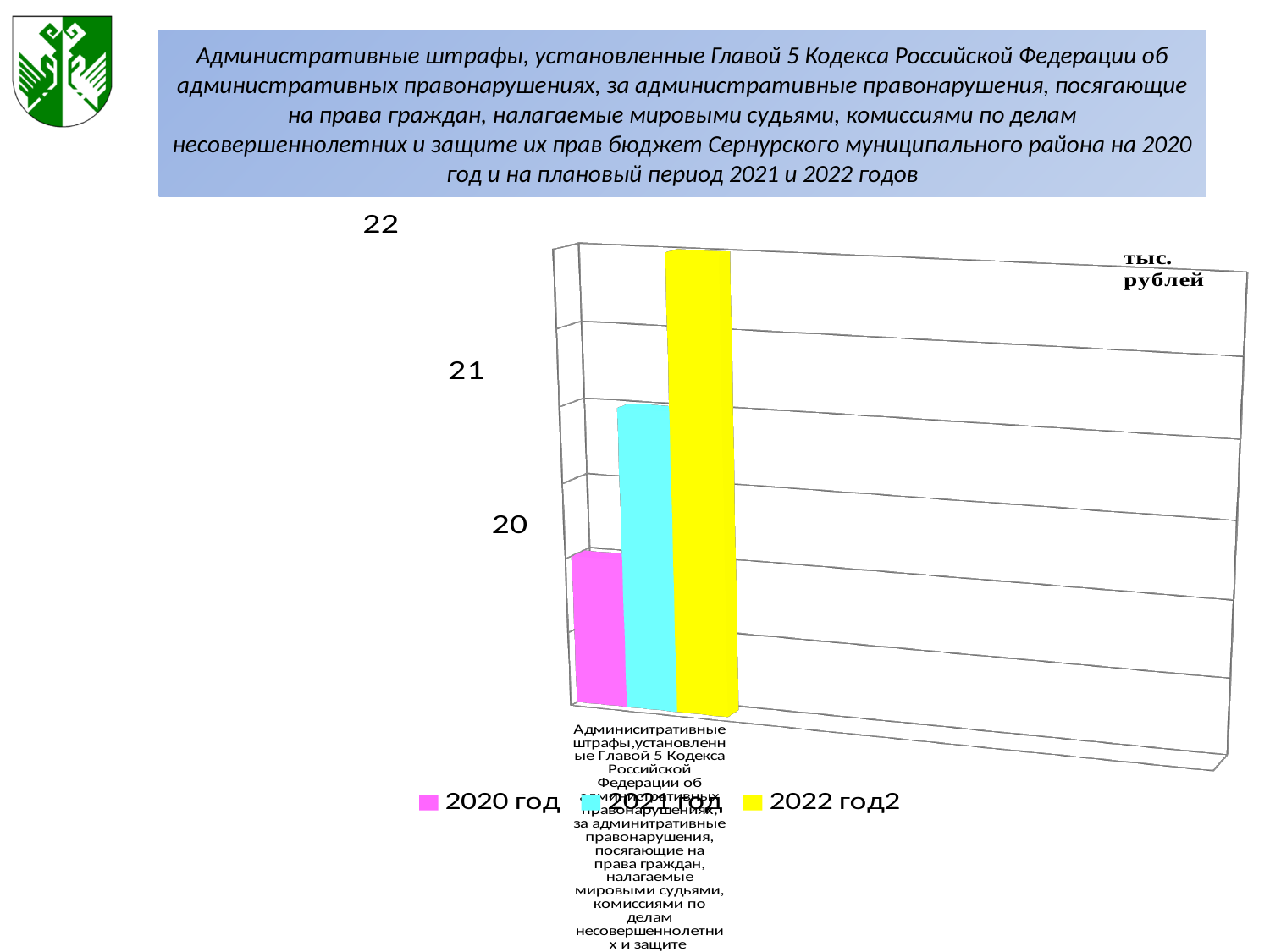
How many series does the legend list? 3 Which series has the highest bar? 2022 год2 What colour is the bar for 2022 год2? yellow Do the values rise or fall from 2020 год to 2022 год2? rise Which series has the lowest bar? 2020 год What unit is indicated in the top right corner of the chart? тыс. рублей Which is larger, the bar for 2021 год or the bar for 2020 год? 2021 год Is the value for 2022 год2 greater or less than 21? greater Is the value for 2020 год greater or less than 21? less Is the value for 2021 год greater or less than 20? greater What kind of chart is shown on the slide? bar chart